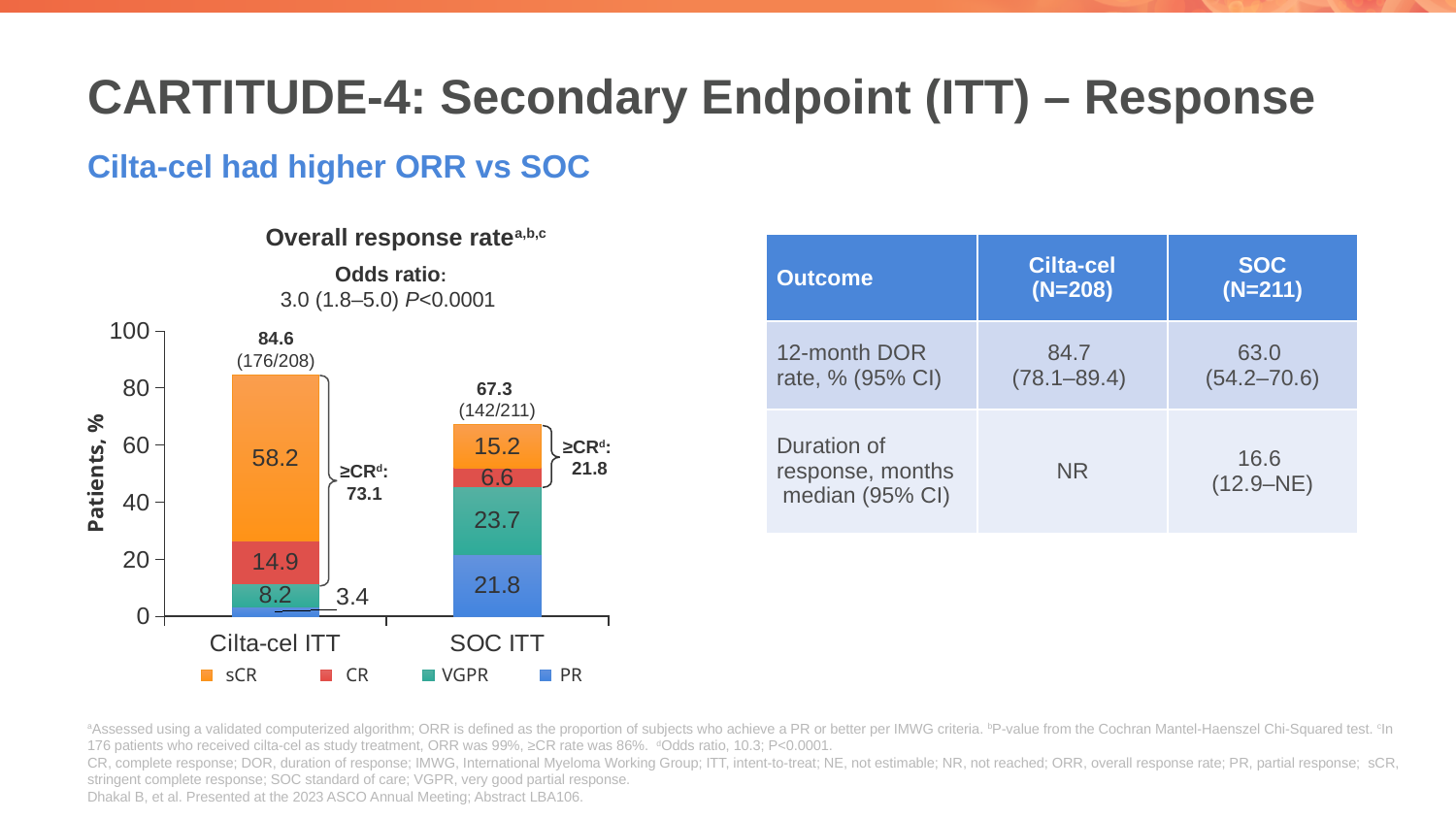
What is the CR value for SOC ITT? 6.6 What type of chart is shown on the slide? Stacked bar chart What is the total overall response rate shown above the Cilta-cel ITT bar? 84.6 How many categories are shown on the x axis of the chart? 2 What is the difference between the sCR values for Cilta-cel ITT and SOC ITT? 43.0 Which category has the higher PR value, Cilta-cel ITT or SOC ITT? SOC ITT What is the VGPR value for SOC ITT? 23.7 What is the sCR value for Cilta-cel ITT? 58.2 How many series does the chart legend list? 4 What is the total overall response rate shown above the SOC ITT bar? 67.3 What is the PR value for Cilta-cel ITT? 3.4 What is the y-axis label of the chart? Patients, %